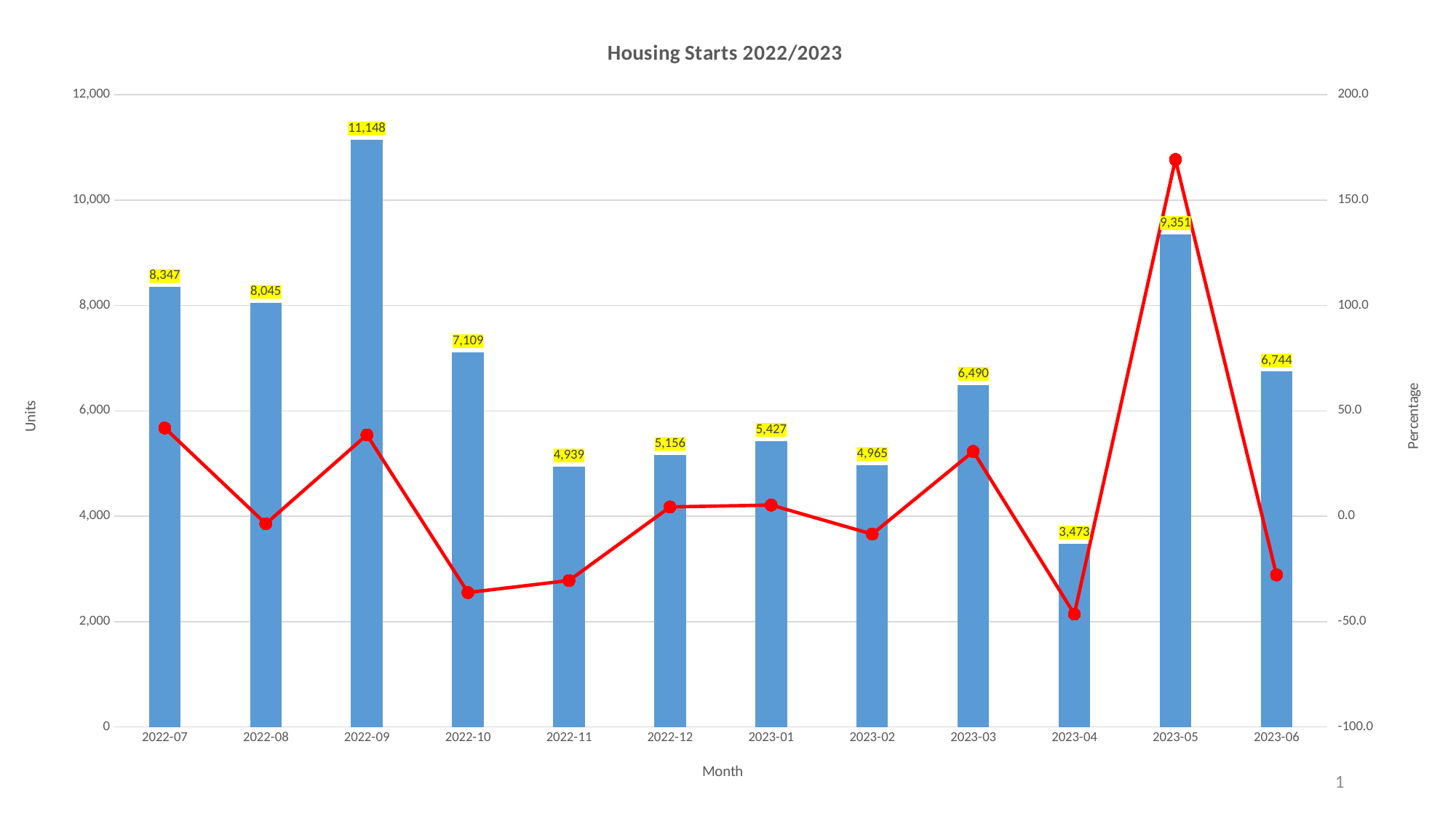
What is the difference in units between 2022-09 and 2023-05? 1,797 Is the percentage value for 2023-05 greater or less than 150.0? greater Is the percentage value for 2023-04 greater or less than 0.0? less What is the number of units for 2023-04? 3,473 What is the title of the chart? Housing Starts 2022/2023 What is the number of units for 2023-01? 5,427 What is the difference in units between 2022-07 and 2022-08? 302 How many months are shown on the x axis? 12 Which month has the highest number of units? 2022-09 What is the number of units for 2022-09? 11,148 Which month has the lowest number of units? 2023-04 Which month has more units, 2023-03 or 2023-06? 2023-06